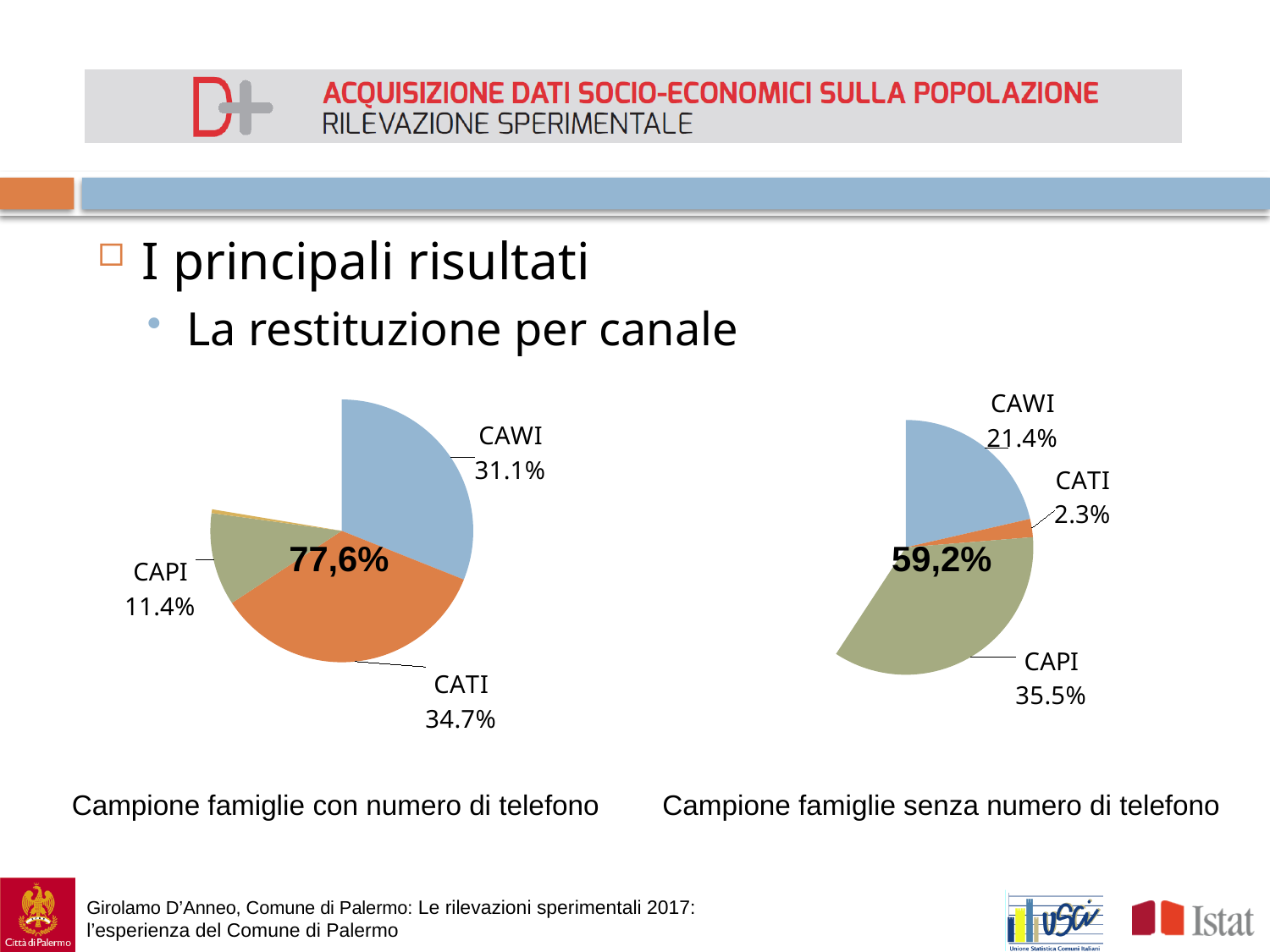
Is the CAPI share larger in the 'con numero di telefono' chart or in the 'senza numero di telefono' chart? senza numero di telefono In the pie chart for 'Campione famiglie senza numero di telefono', which channel has the largest share? CAPI In the pie chart for 'Campione famiglie senza numero di telefono', which channel has the smallest share? CATI In the pie chart for 'Campione famiglie senza numero di telefono', what is the difference between the CAPI and CAWI values? 14.1% In the pie chart for 'Campione famiglie senza numero di telefono', what is the value for CATI? 2.3% What percentage is printed in the centre of the pie chart for 'Campione famiglie senza numero di telefono'? 59,2% In the pie chart for 'Campione famiglie con numero di telefono', what is the value for CAPI? 11.4% What type of chart is used on the left side of the slide? Pie chart In the pie chart for 'Campione famiglie con numero di telefono', what is the value for CATI? 34.7% In the pie chart for 'Campione famiglie con numero di telefono', which labeled channel has the largest share? CATI In the pie chart for 'Campione famiglie senza numero di telefono', what is the value for CAWI? 21.4% In the pie chart for 'Campione famiglie con numero di telefono', what is the difference between the CATI and CAWI values? 3.6%